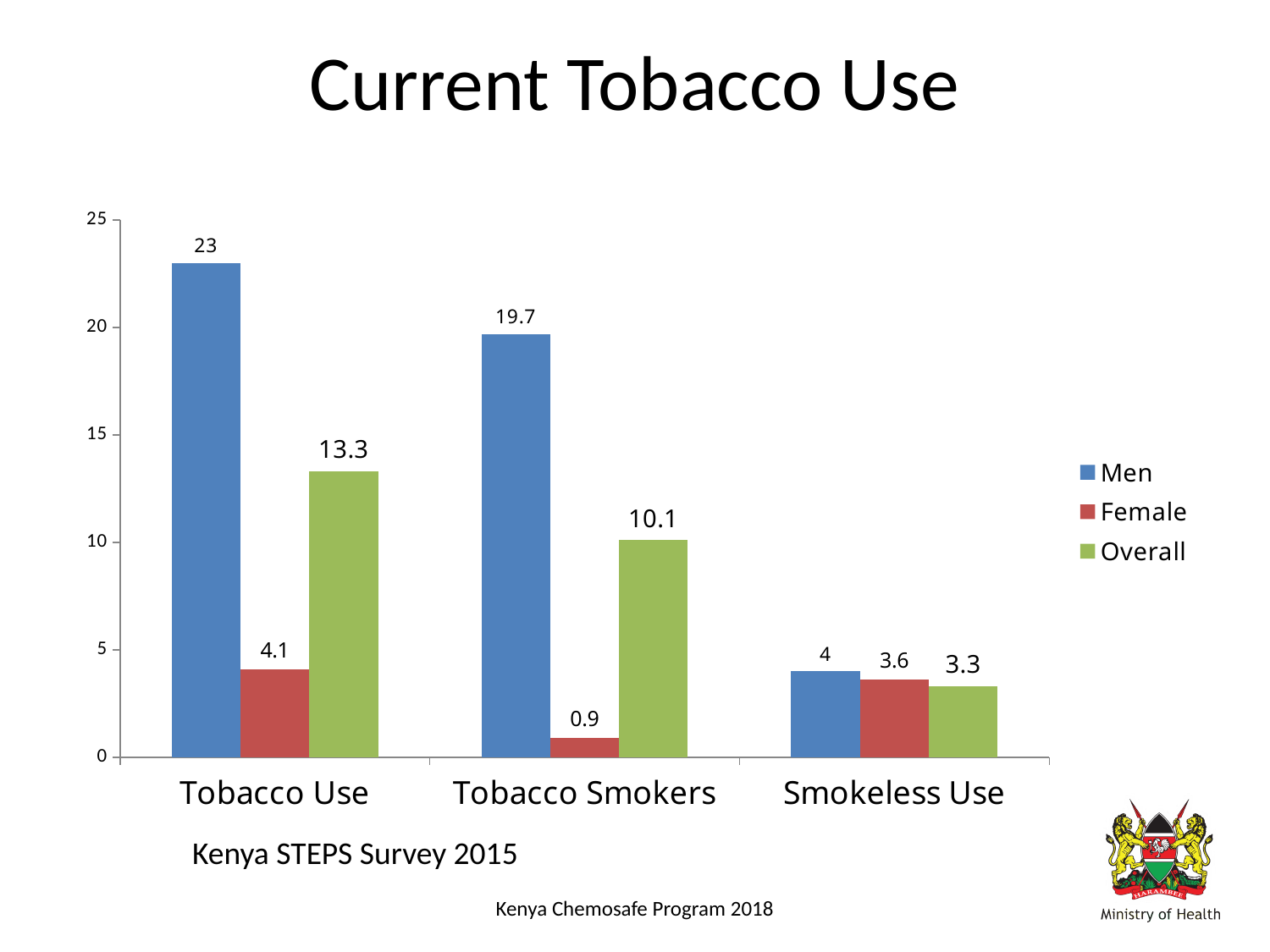
What kind of chart is shown on the slide? bar chart Which category has the lowest value for Female? Tobacco Smokers Which category has the highest value for Men? Tobacco Use Is the value for Men in Tobacco Smokers greater or less than 15? greater How many series does the legend list? 3 Which is larger: the Overall value for Tobacco Use or the Overall value for Tobacco Smokers? Tobacco Use How many categories are shown on the x axis? 3 What is the value for Female in the Tobacco Smokers category? 0.9 What is the difference between the Men and Female values for Tobacco Use? 18.9 What is the title of the slide? Current Tobacco Use What is the value for Men in the Tobacco Use category? 23 What is the Overall value for Smokeless Use? 3.3